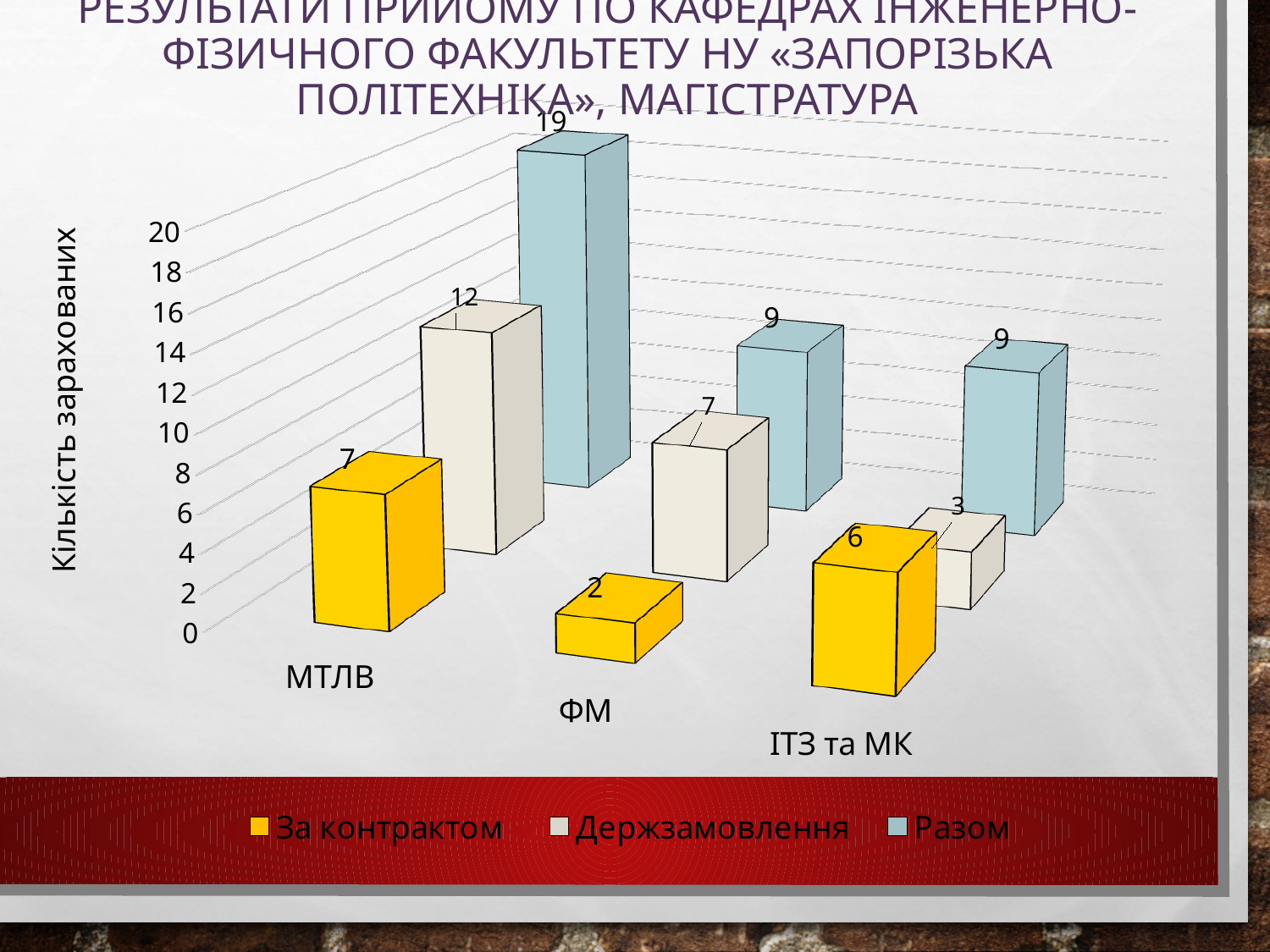
What is the label of the vertical axis? Кількість зарахованих Which category has the highest Разом value? МТЛВ Which is larger: За контрактом for ІТЗ та МК or За контрактом for ФМ? За контрактом for ІТЗ та МК What is the value of Разом for ІТЗ та МК? 9 What is the difference between the Разом values for МТЛВ and ФМ? 10 How many series does the legend list? 3 What kind of chart is shown on the slide? Bar chart What is the value of За контрактом for МТЛВ? 7 What is the value of Держзамовлення for ФМ? 7 Which category has the lowest За контрактом value? ФМ How many categories are shown on the x axis? 3 What is the value of Держзамовлення for ІТЗ та МК? 3